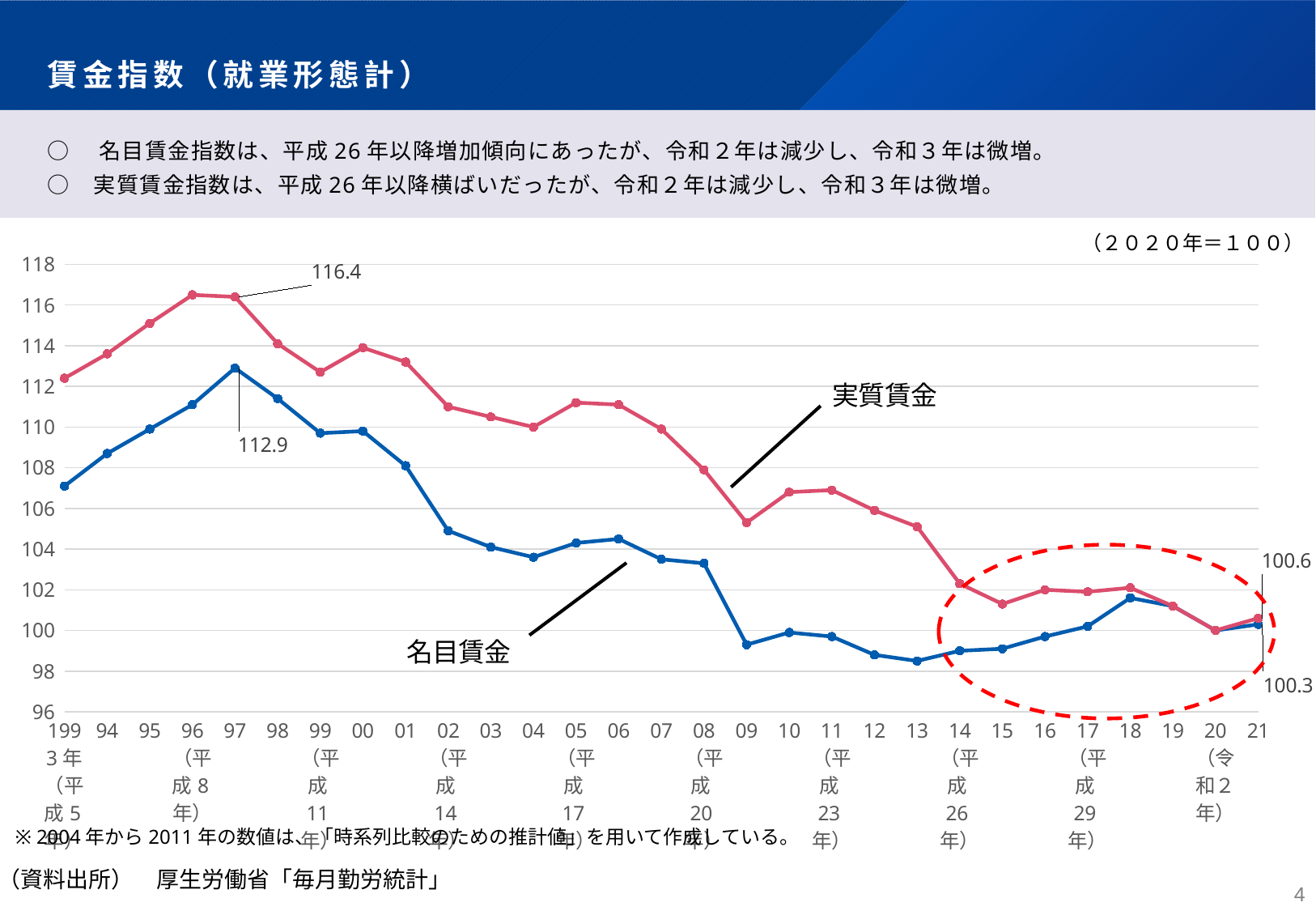
In which year does 名目賃金 reach its highest value? 1997 (平成9年) Which year is used as the base (=100) for the index in this chart? 2020年 What is the difference between 実質賃金 and 名目賃金 in 2021? 0.3 What is the value of 実質賃金 in 1997 (平成9年)? 116.4 What is the difference between 実質賃金 and 名目賃金 in 1997? 3.5 How many data series are plotted on the chart? 2 Is the value for 名目賃金 in 2009 greater or less than 100? less Does 実質賃金 rise or fall overall from 1997 to 2020? fall What is the value of 名目賃金 in 2021 (令和3年)? 100.3 What is the value of 名目賃金 in 1997 (平成9年)? 112.9 What kind of chart is shown on the slide? line chart What is the value of 実質賃金 in 2021 (令和3年)? 100.6